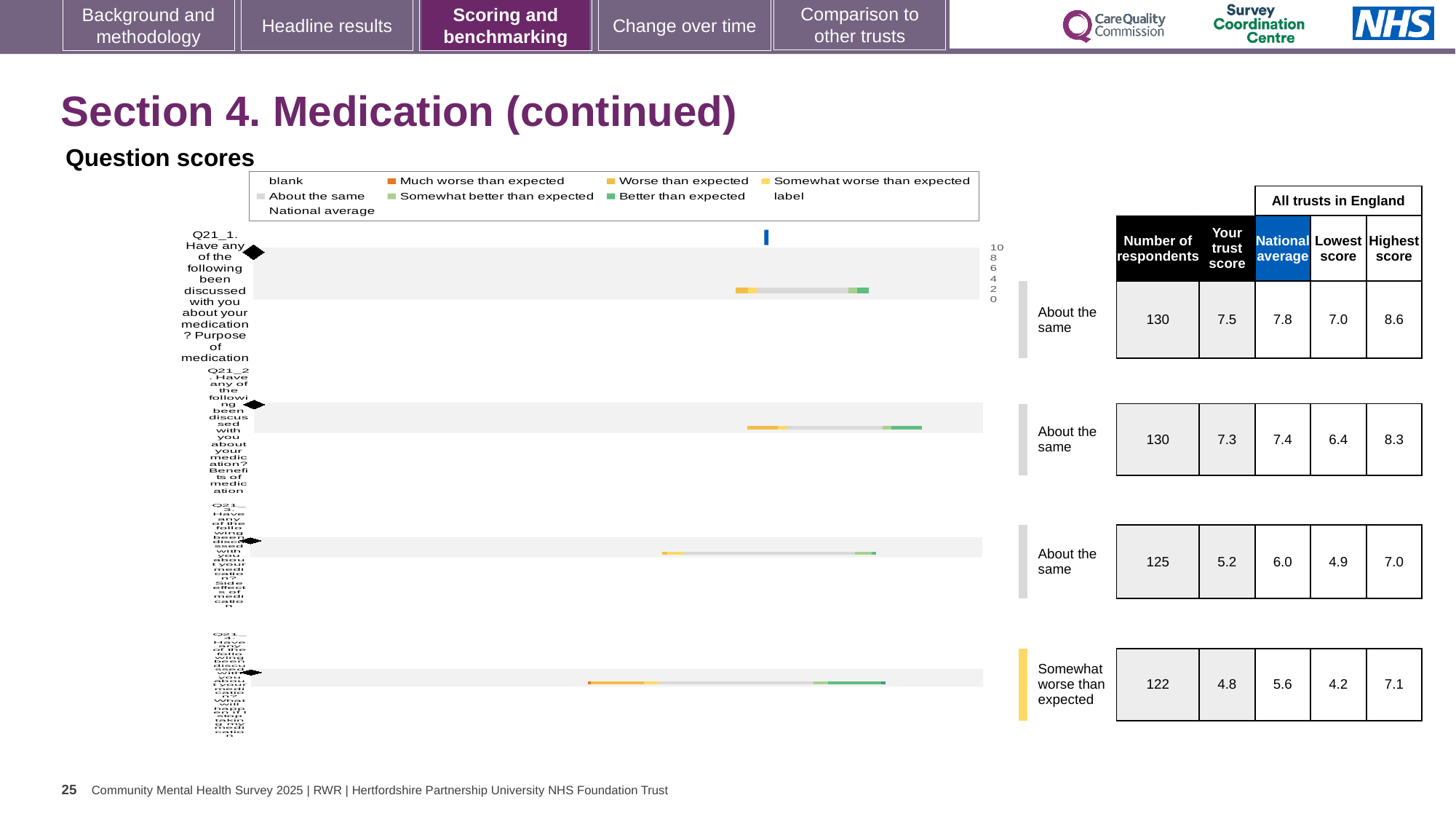
In the table beside the chart, what is the national average for Q21_4 (What might happen if I stop taking medication)? 5.6 In the table beside the chart, which question has the highest 'Your trust score'? Q21_1 How many question bars (Q21_1 to Q21_4) are plotted in the chart? 4 What benchmark category is shown for Q21_4 next to the chart? Somewhat worse than expected What is the highest tick value shown on the chart's axis? 10 In the table beside the chart, what is the 'Your trust score' for Q21_1 (Purpose of medication)? 7.5 How many entries does the chart legend list? 9 In the table beside the chart, what is the difference between the national average and the trust score for Q21_3 (Side effects of medication)? 0.8 What kind of chart is shown under 'Question scores'? bar chart Which legend entry is shown in grey in the chart legend? About the same In the table beside the chart, is the number of respondents for Q21_2 larger or smaller than for Q21_4? larger In the table beside the chart, which question has the lowest 'Your trust score'? Q21_4